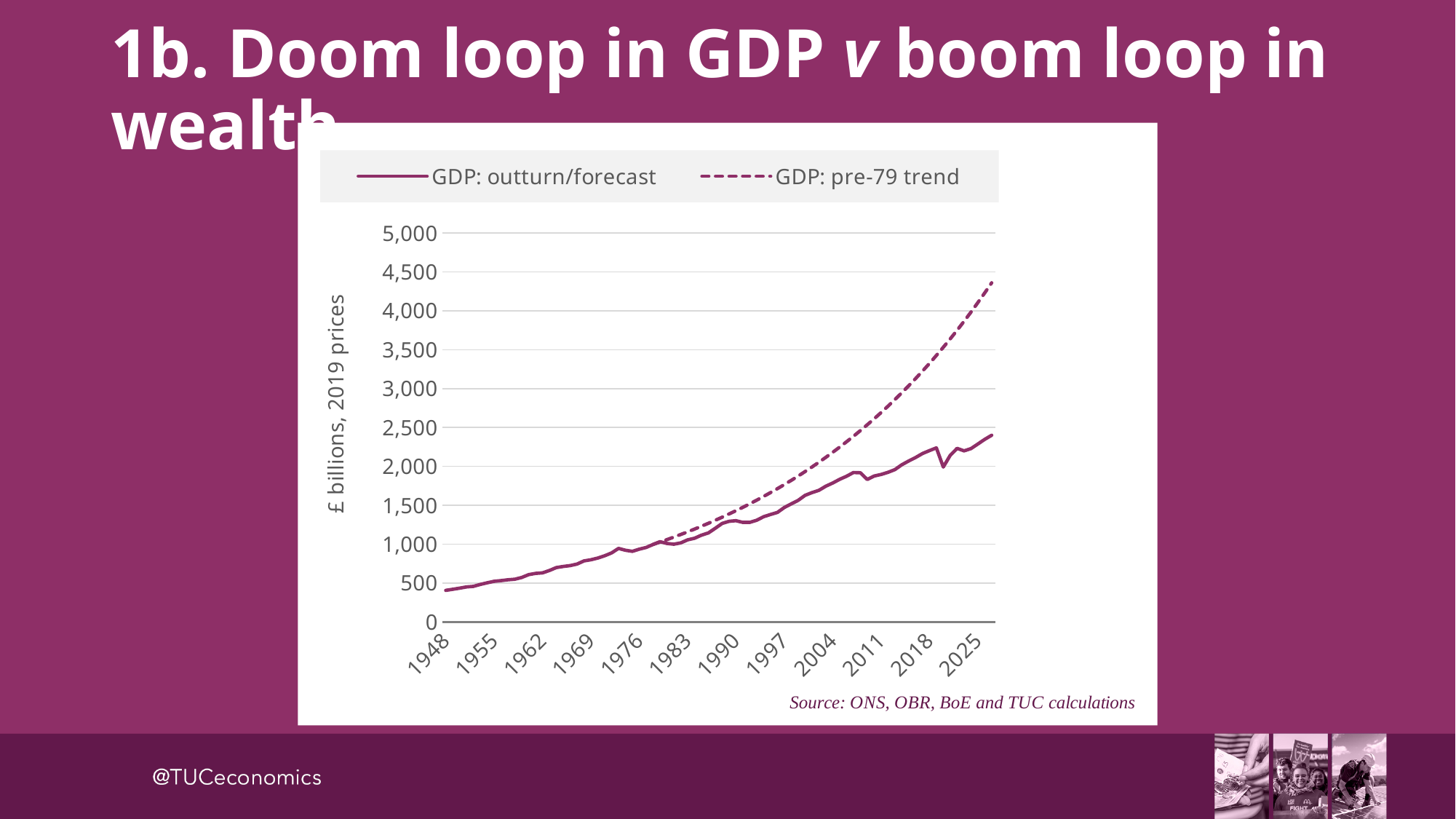
What is the label on the vertical axis of the chart? £ billions, 2019 prices What kind of chart is shown on the slide? line chart Is the value of GDP: outturn/forecast in 2011 greater or less than 1,500? greater What is the highest value shown on the vertical axis of the chart? 5,000 How many series does the chart legend list? 2 Is the value of GDP: pre-79 trend at the right-hand end of the chart greater or less than 3,500? greater Is the value of GDP: outturn/forecast in 1948 greater or less than 500? less What are the two series named in the chart legend? GDP: outturn/forecast and GDP: pre-79 trend How many year labels are shown on the horizontal axis of the chart? 12 At the right-hand end of the chart, which series is higher: GDP: outturn/forecast or GDP: pre-79 trend? GDP: pre-79 trend Does the GDP: outturn/forecast line generally rise or fall from 1948 to 2025? rise